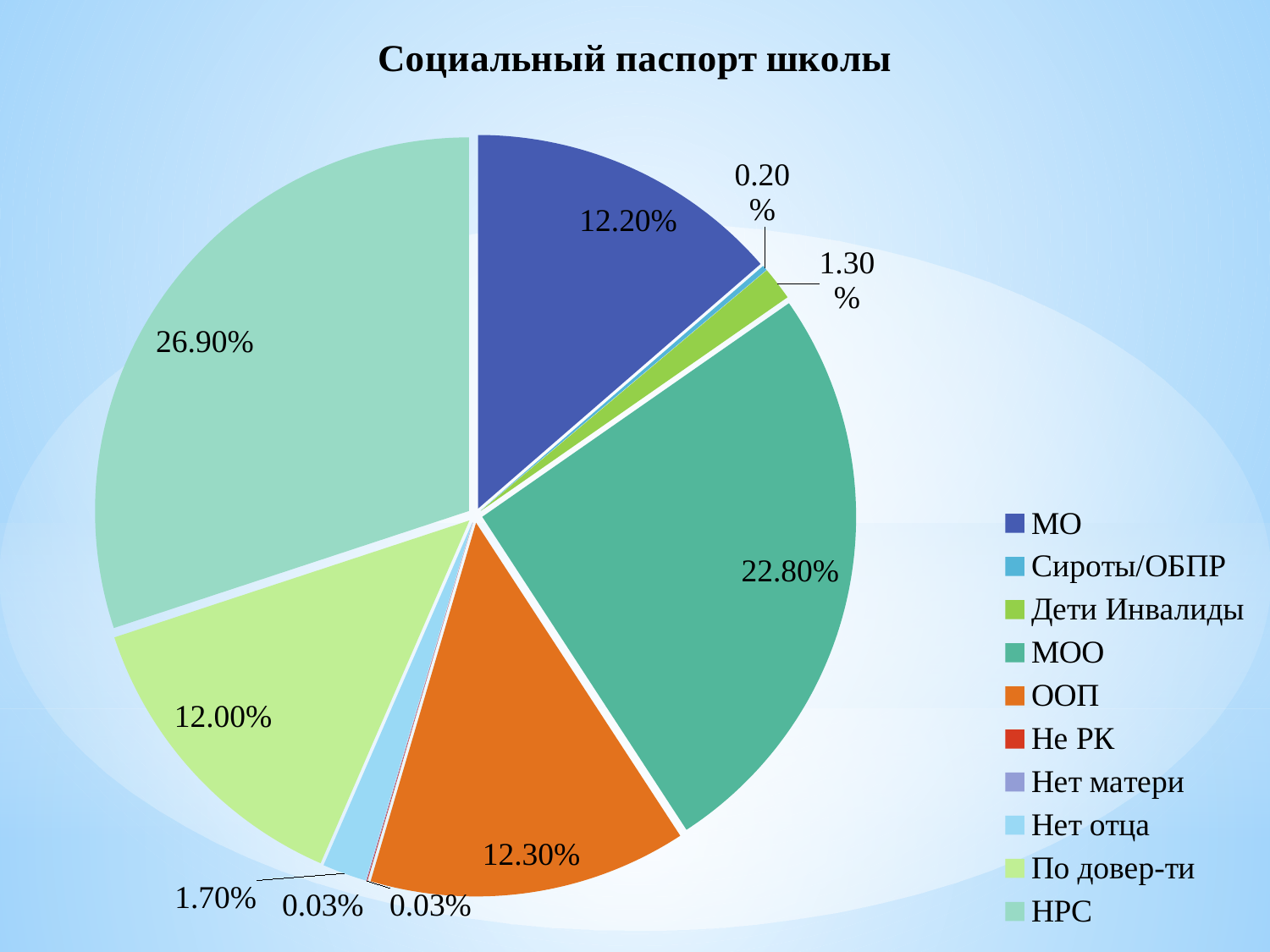
What is the difference between the values for НРС and МОО? 4.10% What is the value for МОО? 22.80% What is the value for МО? 12.20% Which is larger, the value for МОО or the value for По довер-ти? МОО What is the title of the chart? Социальный паспорт школы How many categories does the legend list? 10 What is the value for ООП? 12.30% What is the value for Нет отца? 1.70% Which category has the largest share of the pie? НРС What kind of chart is shown on the slide? pie chart What is the value for Дети Инвалиды? 1.30% What is the value for НРС? 26.90%